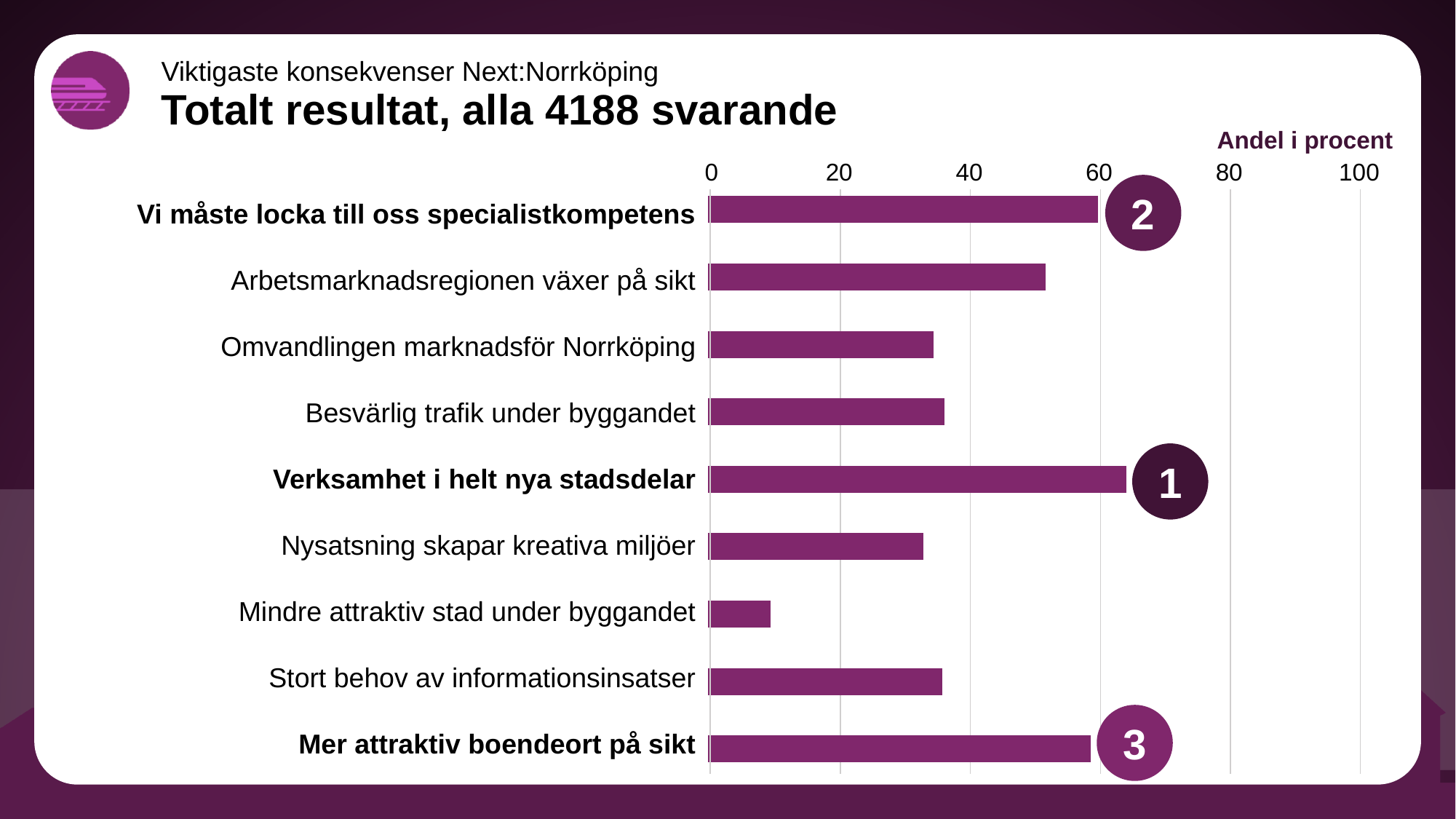
Which category has the lowest value? Mindre attraktiv stad under byggandet Is the value for Mindre attraktiv stad under byggandet greater or less than 20? less Is the value for Arbetsmarknadsregionen växer på sikt greater or less than 40? greater Which category has the highest value? Verksamhet i helt nya stadsdelar Which is larger: the value for Arbetsmarknadsregionen växer på sikt or for Omvandlingen marknadsför Norrköping? Arbetsmarknadsregionen växer på sikt What is the label shown above the horizontal axis of the chart? Andel i procent What kind of chart is shown on the slide? bar chart Is the value for Verksamhet i helt nya stadsdelar greater or less than 60? greater How many categories are plotted in the chart? 9 What number is shown in the circle next to the bar for Verksamhet i helt nya stadsdelar? 1 Which is larger: the value for Stort behov av informationsinsatser or for Mindre attraktiv stad under byggandet? Stort behov av informationsinsatser